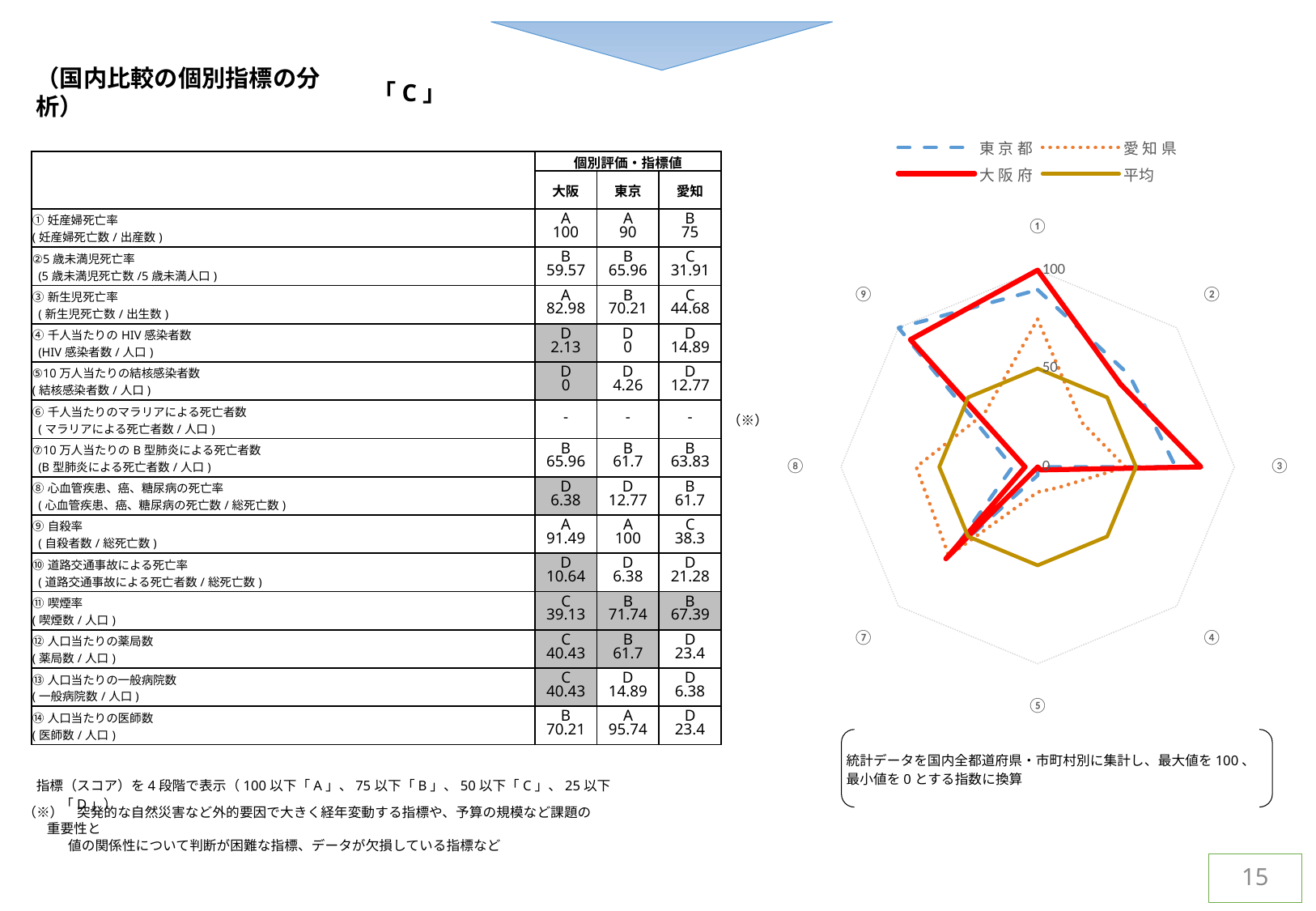
What is the maximum value shown on the radial axis of the radar chart? 100 In the radar chart, what is the value for 大阪府 on axis ①? 100 In the radar chart, is the value for 愛知県 on axis ② greater or less than 50? less How many series does the legend of the radar chart list? 4 How many numbered axes (categories) does the radar chart have? 8 In the radar chart, which series has the higher value on axis ①, 大阪府 or 東京都? 大阪府 In the radar chart, which series has the higher value on axis ⑨, 東京都 or 大阪府? 東京都 In the radar chart, is the value for 東京都 on axis ⑧ greater or less than 50? less In the radar chart, is the value for 大阪府 on axis ③ greater or less than 50? greater In the radar chart, which series has the highest value on axis ③? 大阪府 What kind of chart is shown on the right side of the slide? radar chart